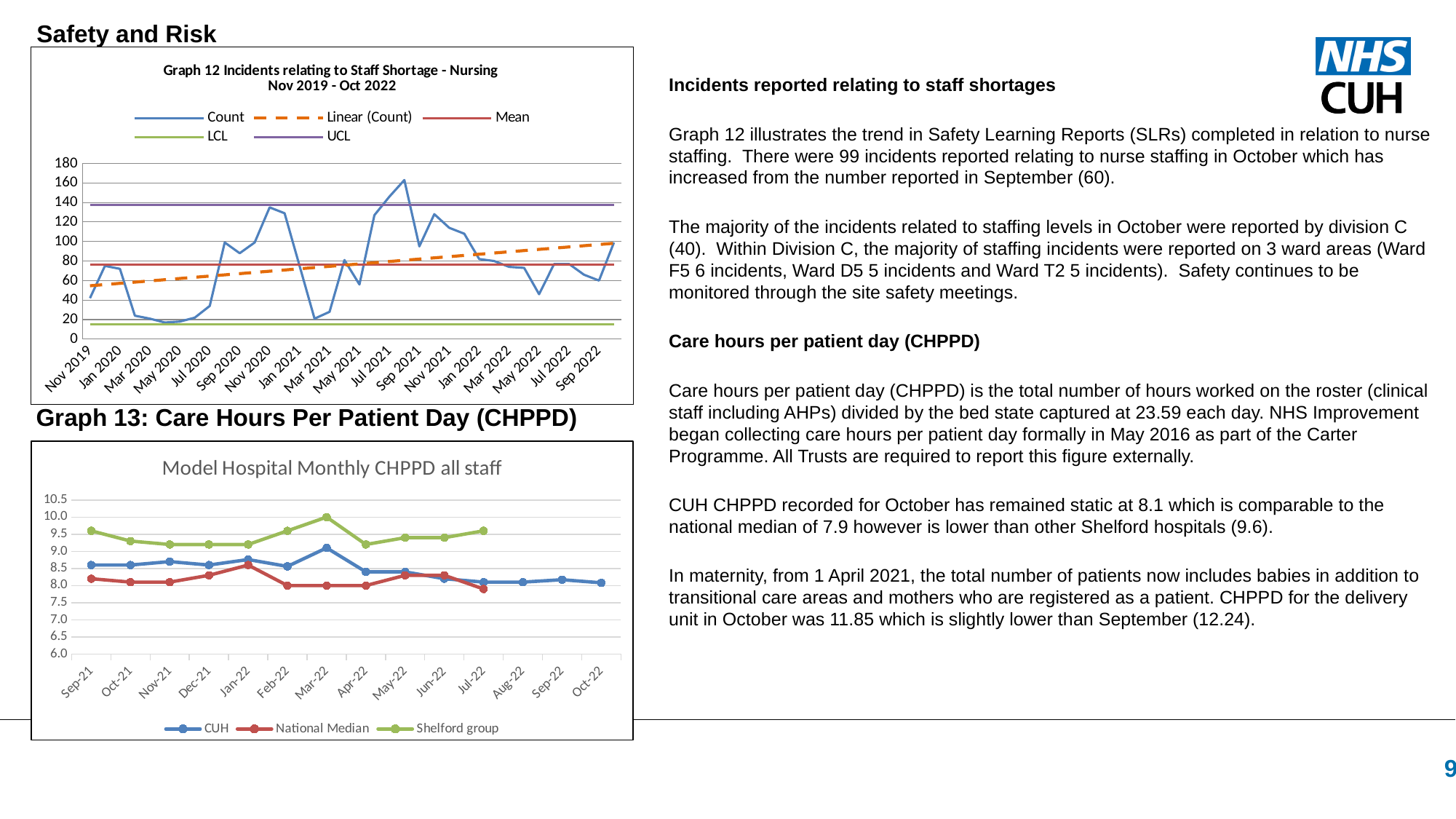
In the Model Hospital Monthly CHPPD all staff chart, is the Shelford group value for Mar-22 greater or less than 9.5? greater How many months are shown on the x axis of the Model Hospital Monthly CHPPD all staff chart? 14 What kind of chart is the Model Hospital Monthly CHPPD all staff chart? Line chart In Graph 12 Incidents relating to Staff Shortage - Nursing, is the Count value for Mar 2021 greater or less than 40? less In the Model Hospital Monthly CHPPD all staff chart, which series has the highest values across the period? Shelford group In Graph 12 Incidents relating to Staff Shortage - Nursing, does the Linear (Count) trend line rise or fall from Nov 2019 to Sep 2022? Rises In Graph 12 Incidents relating to Staff Shortage - Nursing, is the highest value of the Count series greater or less than 140? greater How many series does the legend of Graph 12 Incidents relating to Staff Shortage - Nursing list? 5 In the Model Hospital Monthly CHPPD all staff chart, which is higher in Sep-21: CUH or National Median? CUH How many series does the legend of the Model Hospital Monthly CHPPD all staff chart list? 3 What kind of chart is Graph 12 Incidents relating to Staff Shortage - Nursing? Line chart